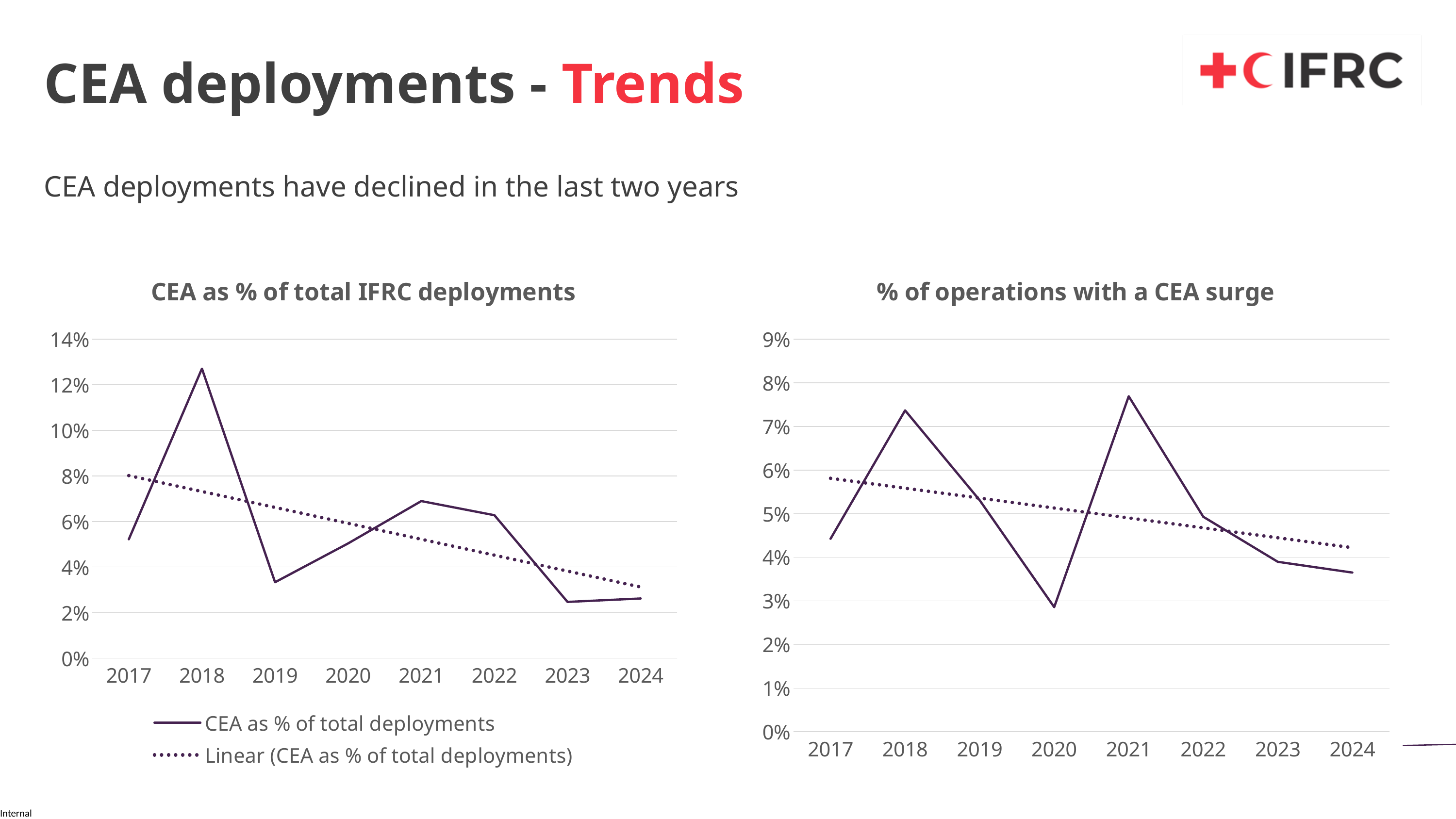
On the chart titled 'CEA as % of total IFRC deployments', is the value for 2023 greater or less than 4%? less On the chart titled '% of operations with a CEA surge', which year has the larger value, 2021 or 2020? 2021 On the chart titled '% of operations with a CEA surge', is the value for 2020 greater or less than 3%? less On the chart titled '% of operations with a CEA surge', do the values rise or fall from 2021 to 2024? Fall How many entries does the legend of the chart titled 'CEA as % of total IFRC deployments' list? 2 On the chart titled 'CEA as % of total IFRC deployments', which year has the highest value? 2018 What kind of chart is the chart titled 'CEA as % of total IFRC deployments'? Line chart On the chart titled '% of operations with a CEA surge', which year has the lowest value? 2020 How many years are shown on the x axis of the chart titled '% of operations with a CEA surge'? 8 On the chart titled 'CEA as % of total IFRC deployments', which year has the larger value, 2018 or 2019? 2018 On the chart titled 'CEA as % of total IFRC deployments', is the value for 2018 greater or less than 12%? greater